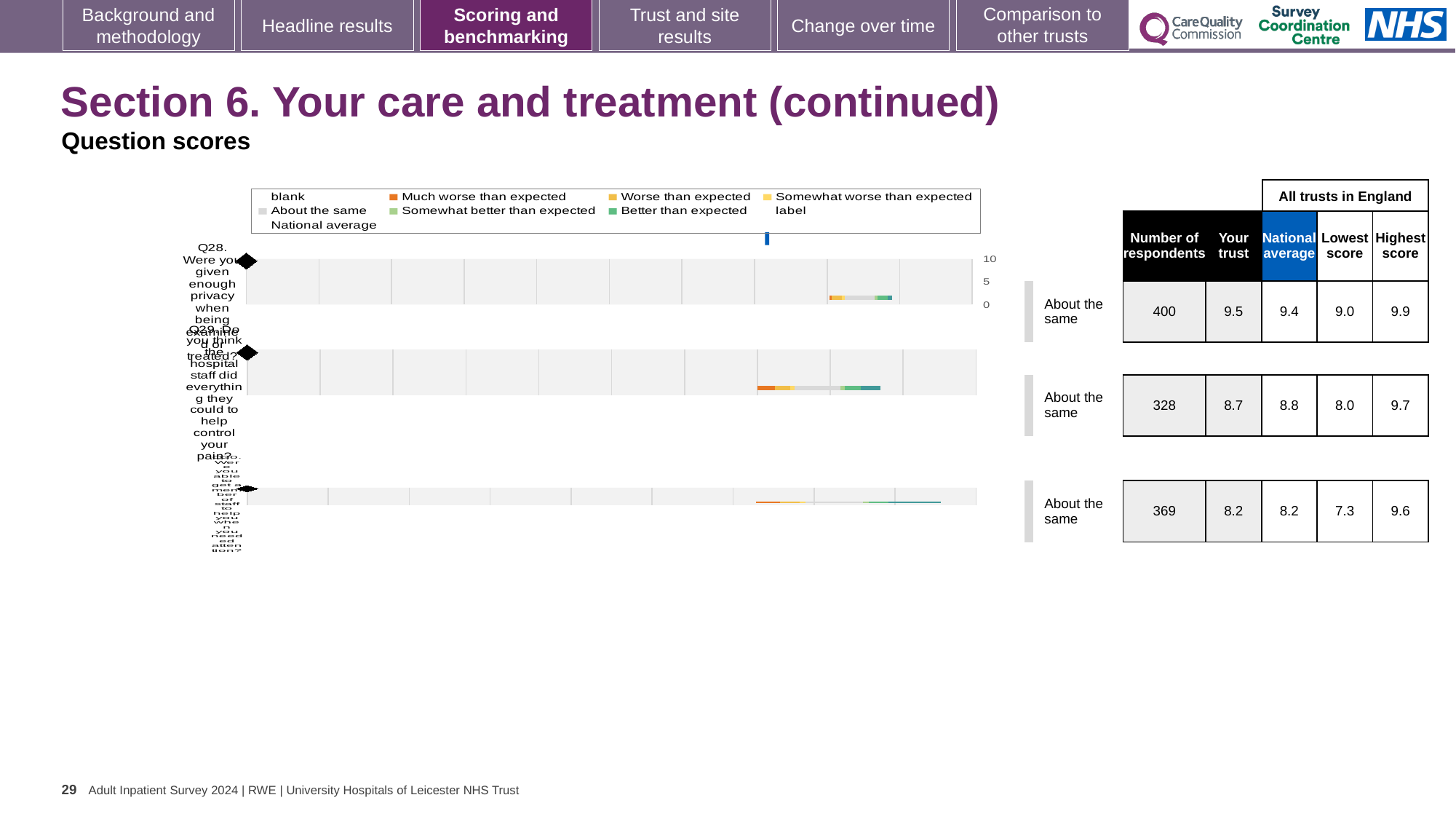
What is the highest value shown on the chart's score axis? 10 What is the difference between the highest score and the lowest score for Q30? 2.3 What colour does the legend use for 'Much worse than expected'? orange What is the national average score for Q29 (hospital staff helping control pain)? 8.8 Which question has the largest number of respondents? Q28 How many questions (rows) are plotted in the question scores chart? 3 Which has the higher 'Your trust' score, Q28 or Q30? Q28 Which question has the lowest 'Lowest score' among all trusts in England? Q30 What is the difference between the highest score and the lowest score for Q28? 0.9 What is the 'Your trust' score for Q28 (privacy when being examined or treated)? 9.5 What kind of chart is used to show the question scores on this slide? bar chart What benchmark category is shown for Q29? About the same